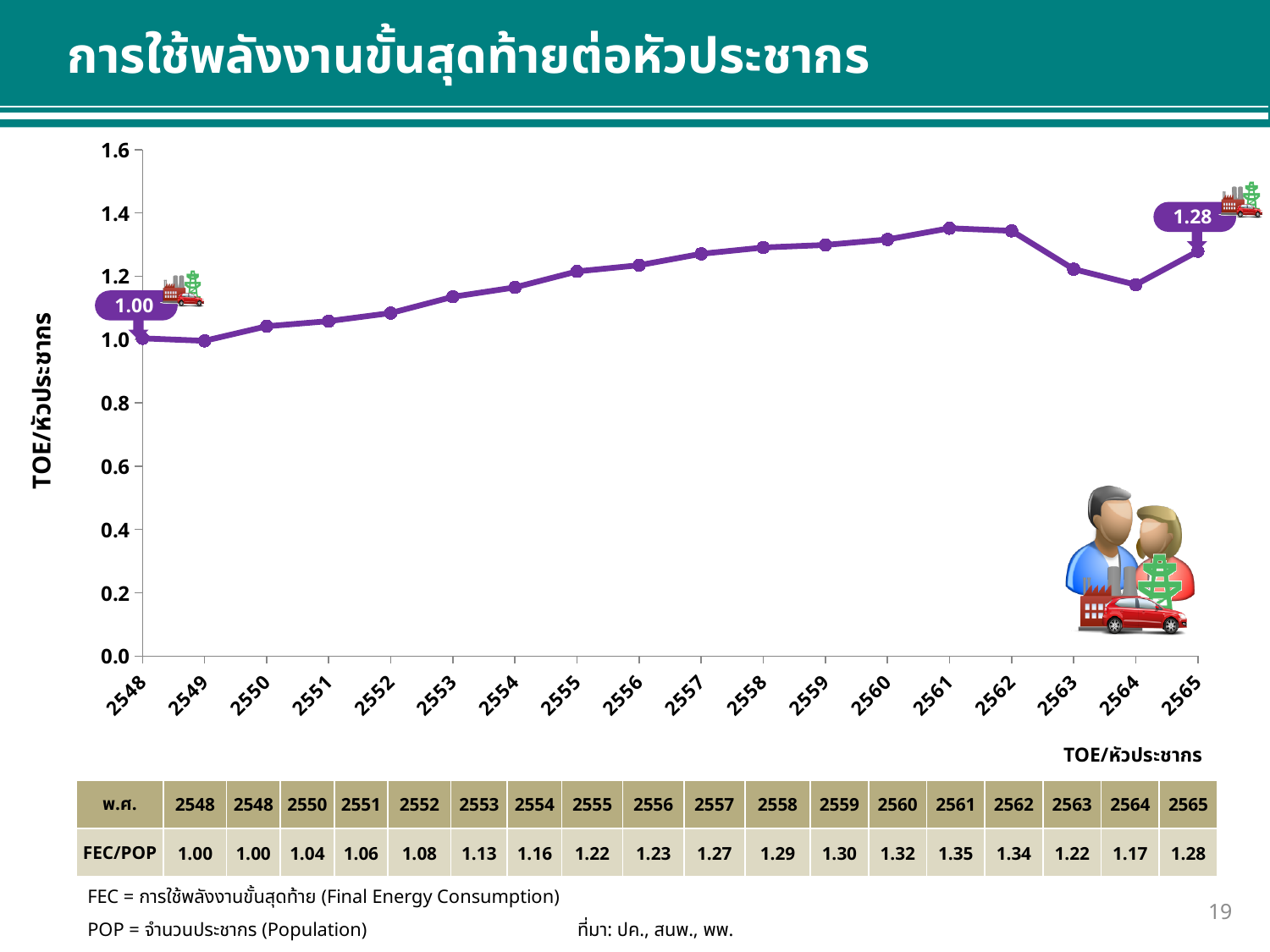
What kind of chart is shown on the slide? line chart How many years are plotted on the x axis of the chart? 18 What is the FEC/POP value for 2557? 1.27 What is the FEC/POP value for 2548? 1.00 What is the difference between the FEC/POP value in 2565 and in 2548? 0.28 Is the value for 2552 greater or less than 1.2? less Do the values generally rise or fall from 2548 to 2561? rise What is the FEC/POP value for 2564? 1.17 Which year has the larger FEC/POP value, 2563 or 2564? 2563 What is the label on the y axis of the chart? TOE/หัวประชากร In which year is the FEC/POP value highest? 2561 What is the FEC/POP value for 2565? 1.28